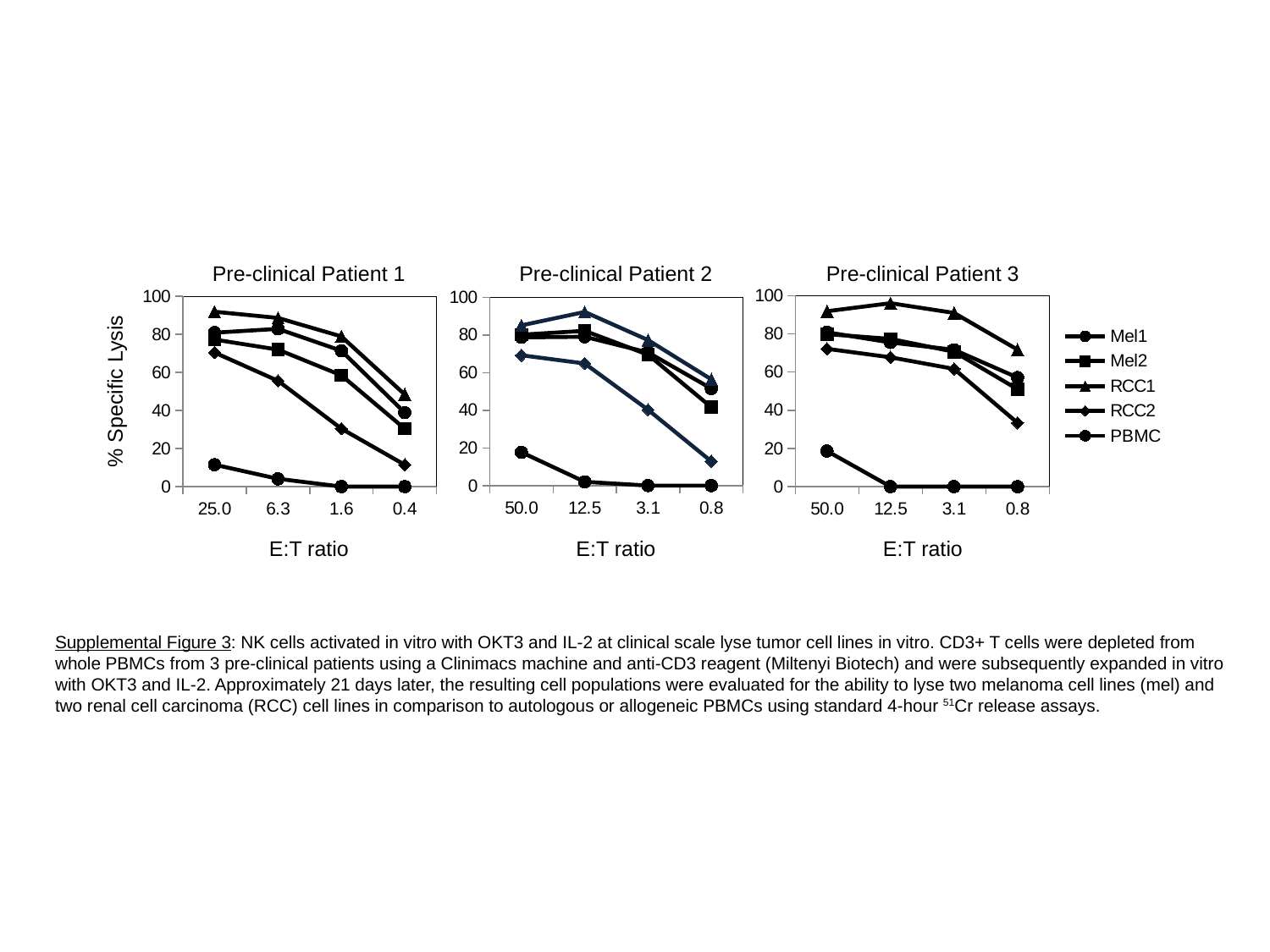
In the Pre-clinical Patient 1 chart, does the RCC2 series rise or fall as you move from left to right along the x axis? falls In the Pre-clinical Patient 2 chart, which is larger at an E:T ratio of 12.5, RCC1 or RCC2? RCC1 What kind of chart is used for Pre-clinical Patient 1? line chart In the Pre-clinical Patient 3 chart, what is the % Specific Lysis for PBMC at an E:T ratio of 0.8? 0 How many series does the legend list for the charts? 5 In the Pre-clinical Patient 1 chart, which series has the lowest % Specific Lysis at an E:T ratio of 25.0? PBMC What is the y-axis label on the Pre-clinical Patient 1 chart? % Specific Lysis In the Pre-clinical Patient 1 chart, how many E:T ratio points are plotted along the x axis? 4 What is the x-axis label on the three charts? E:T ratio In the Pre-clinical Patient 3 chart, which series has the highest % Specific Lysis at an E:T ratio of 12.5? RCC1 In the Pre-clinical Patient 1 chart, is the value for RCC1 at an E:T ratio of 25.0 greater or less than 80? greater In the Pre-clinical Patient 2 chart, is the value for RCC2 at an E:T ratio of 0.8 greater or less than 20? less